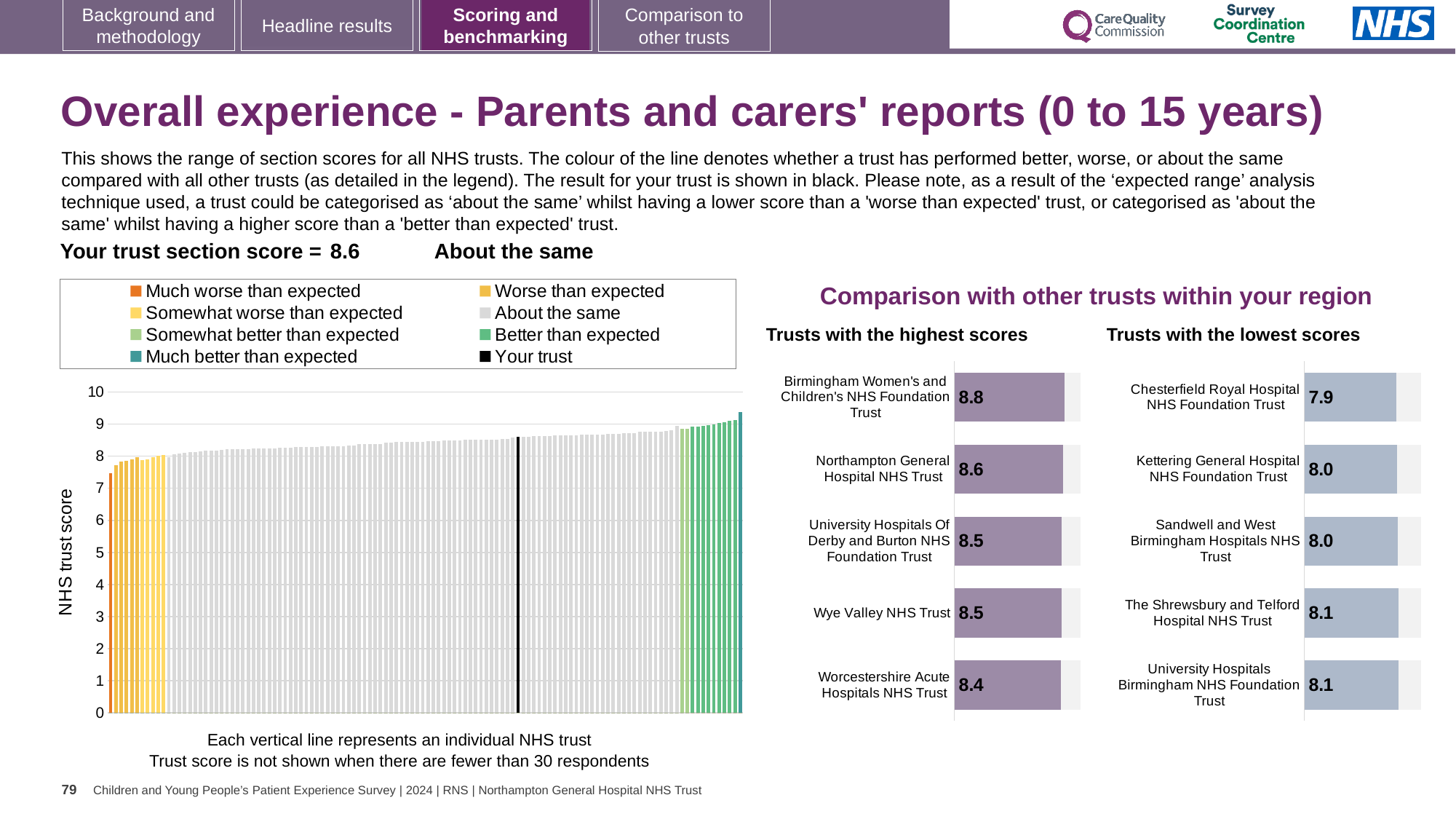
In the 'Trusts with the highest scores' chart, which trust has the lowest score? Worcestershire Acute Hospitals NHS Trust In the 'Trusts with the lowest scores' chart, which trust has the lowest score? Chesterfield Royal Hospital NHS Foundation Trust In the large 'NHS trust score' chart on the left, do the bar values rise or fall from left to right along the x axis? Rise How many entries does the legend of the large 'NHS trust score' chart on the left list? 8 In the 'Trusts with the highest scores' chart, what is the difference between the scores of Birmingham Women's and Children's NHS Foundation Trust and Worcestershire Acute Hospitals NHS Trust? 0.4 In the large 'NHS trust score' chart on the left, is the value of the leftmost (orange) bar greater or less than 8? less In the 'Trusts with the highest scores' chart, what is the score for Wye Valley NHS Trust? 8.5 In the 'Trusts with the highest scores' chart, what is the score for Birmingham Women's and Children's NHS Foundation Trust? 8.8 In the 'Trusts with the lowest scores' chart, what is the score for Chesterfield Royal Hospital NHS Foundation Trust? 7.9 What kind of chart is the large chart on the left with the y axis labelled 'NHS trust score'? Bar chart How many trusts are listed in the 'Trusts with the lowest scores' chart? 5 In the 'Trusts with the lowest scores' chart, which has the higher score: Kettering General Hospital NHS Foundation Trust or The Shrewsbury and Telford Hospital NHS Trust? The Shrewsbury and Telford Hospital NHS Trust